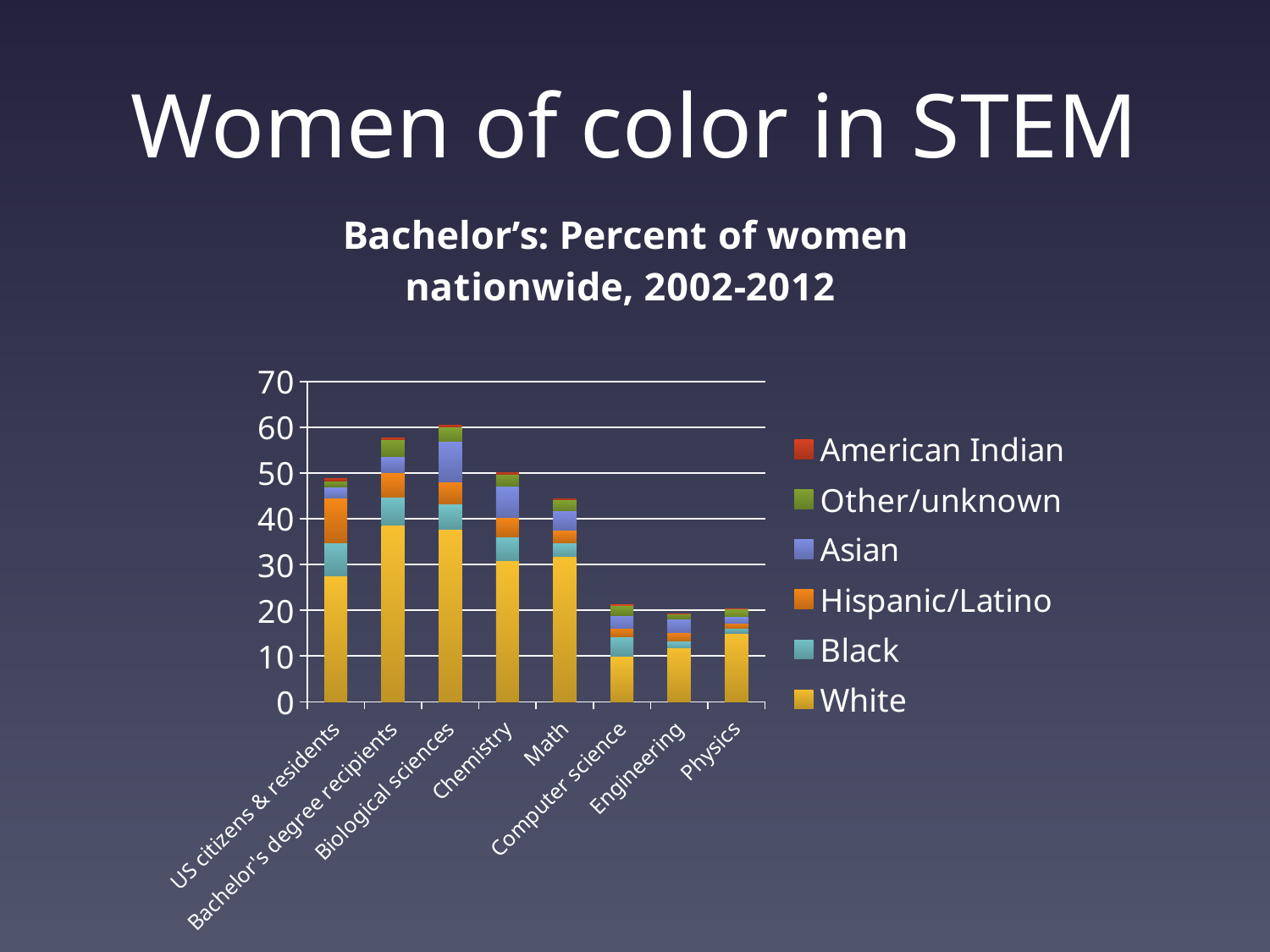
How many categories are shown along the x axis of the chart? 8 Which series is listed at the bottom of the legend? White How many series does the chart's legend list? 6 What kind of chart is shown on the slide? Stacked bar chart Which has the taller stacked bar, US citizens & residents or Engineering? US citizens & residents Which category has the tallest stacked bar? Biological sciences What is the title of the chart? Bachelor's: Percent of women nationwide, 2002-2012 Is the White segment for Bachelor's degree recipients greater or less than 30? greater Is the White segment for Computer science greater or less than 20? less Which has the taller stacked bar, Chemistry or Math? Chemistry Is the total stacked bar for Math greater or less than 40? greater